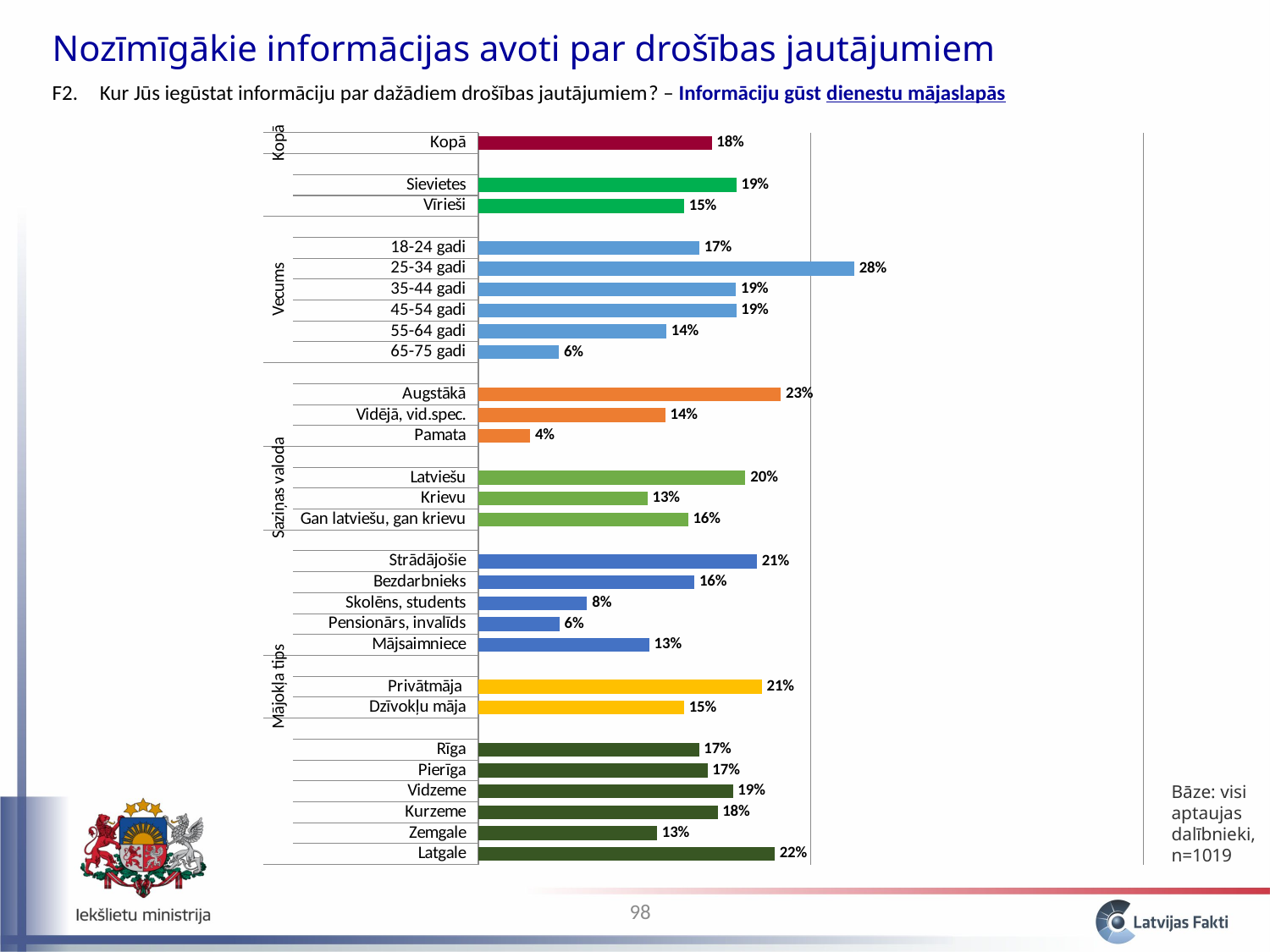
What is the difference between the values for Sievietes and Vīrieši? 4% What is the value for Strādājošie? 21% What type of chart is shown on the slide? Bar chart Which is larger, the value for Privātmāja or Dzīvokļu māja? Privātmāja What is the value for Pamata? 4% What is the value for 25-34 gadi? 28% Which age group (Vecums) has the lowest value? 65-75 gadi How many bars are plotted in the chart? 28 What is the value for Kopā? 18% Which region among Rīga, Pierīga, Vidzeme, Kurzeme, Zemgale and Latgale has the highest value? Latgale Which is larger, the value for Latviešu or Krievu? Latviešu What is the difference between the values for Augstākā and Vidējā, vid.spec.? 9%